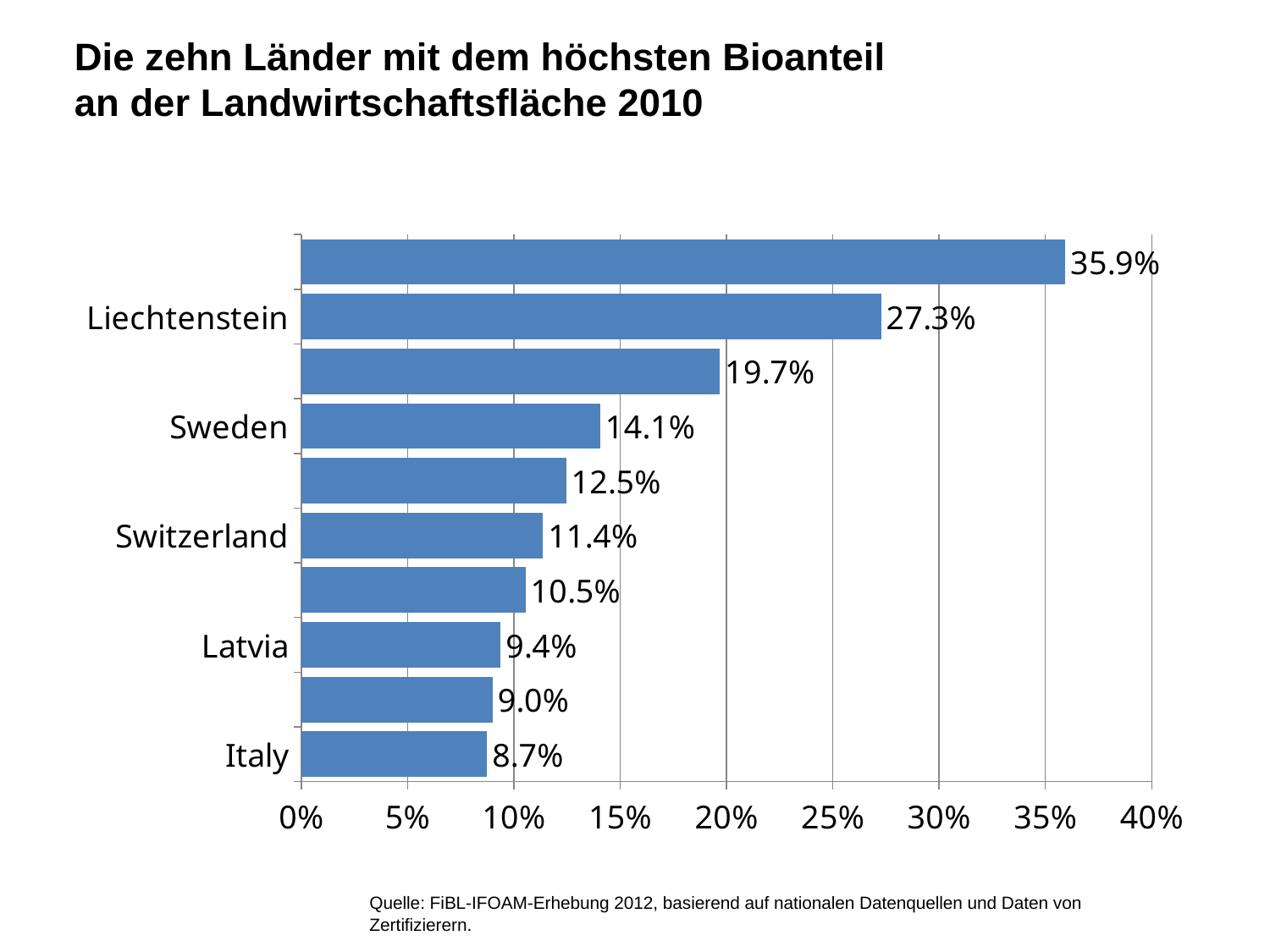
What kind of chart is shown on the slide? bar chart How many bars are shown on the chart? 10 What is the value for Sweden? 14.1% Which is larger, the value for Sweden or the value for Switzerland? Sweden Which labelled country has the lowest value? Italy Is the value for Italy greater or less than 10%? less What is the difference between the values for Liechtenstein and Sweden? 13.2 percentage points What is the value for Latvia? 9.4% What is the value for Liechtenstein? 27.3% What is the value for Switzerland? 11.4% What is the value for Italy? 8.7% What is the highest value shown on the chart? 35.9%